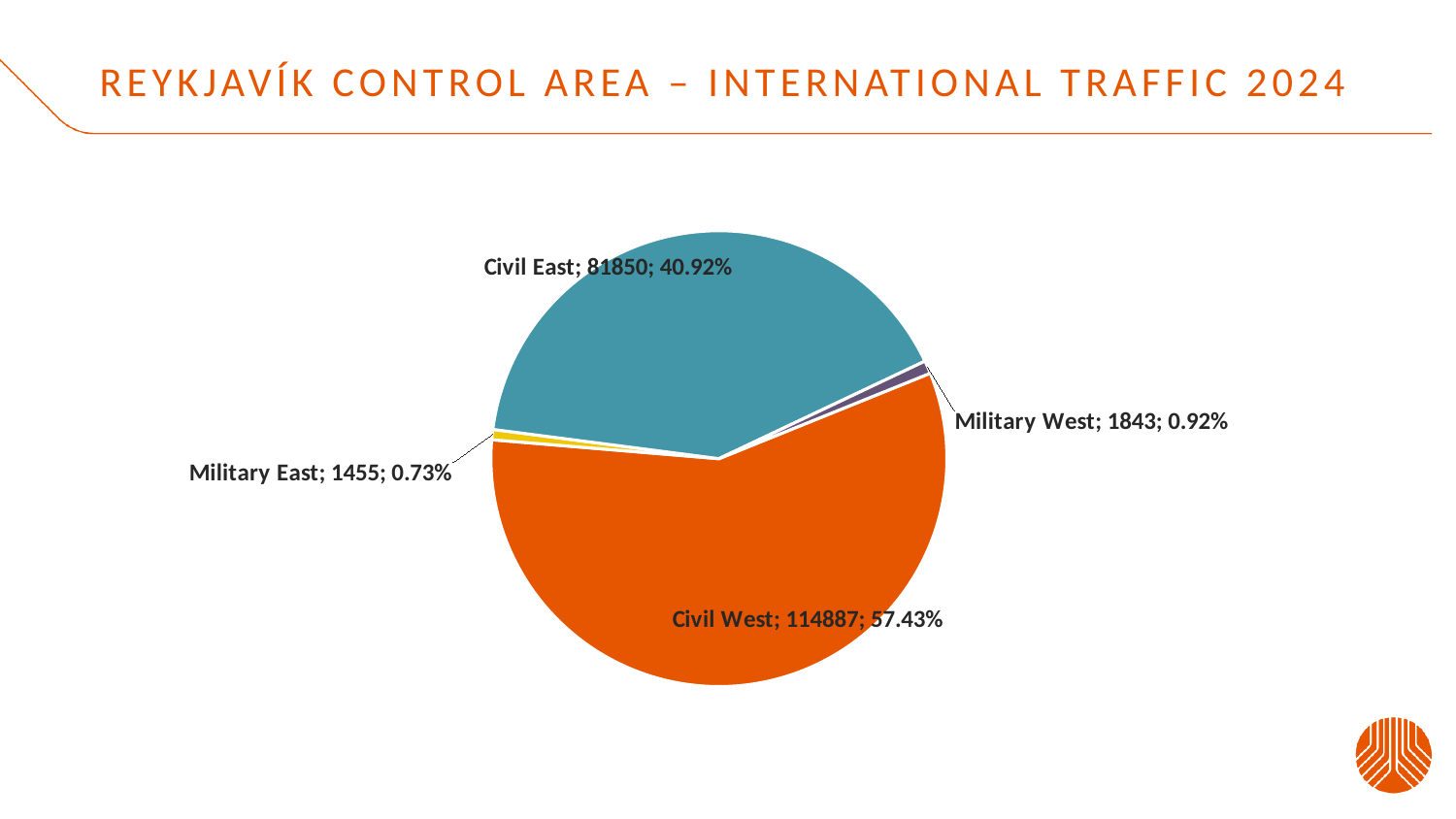
Which category has the smallest slice? Military East What share of the pie does Military East represent? 0.73% What is the title of the chart on the slide? Reykjavík Control Area – International Traffic 2024 How many slices does the pie chart have? 4 What is the value for Military West? 1843 Which category has the largest slice? Civil West What share of the pie does Civil West represent? 57.43% What kind of chart is shown on the slide? Pie chart What is the value for Civil East? 81850 What is the value for Civil West? 114887 What is the difference between the values for Civil West and Civil East? 33037 What is the value for Military East? 1455